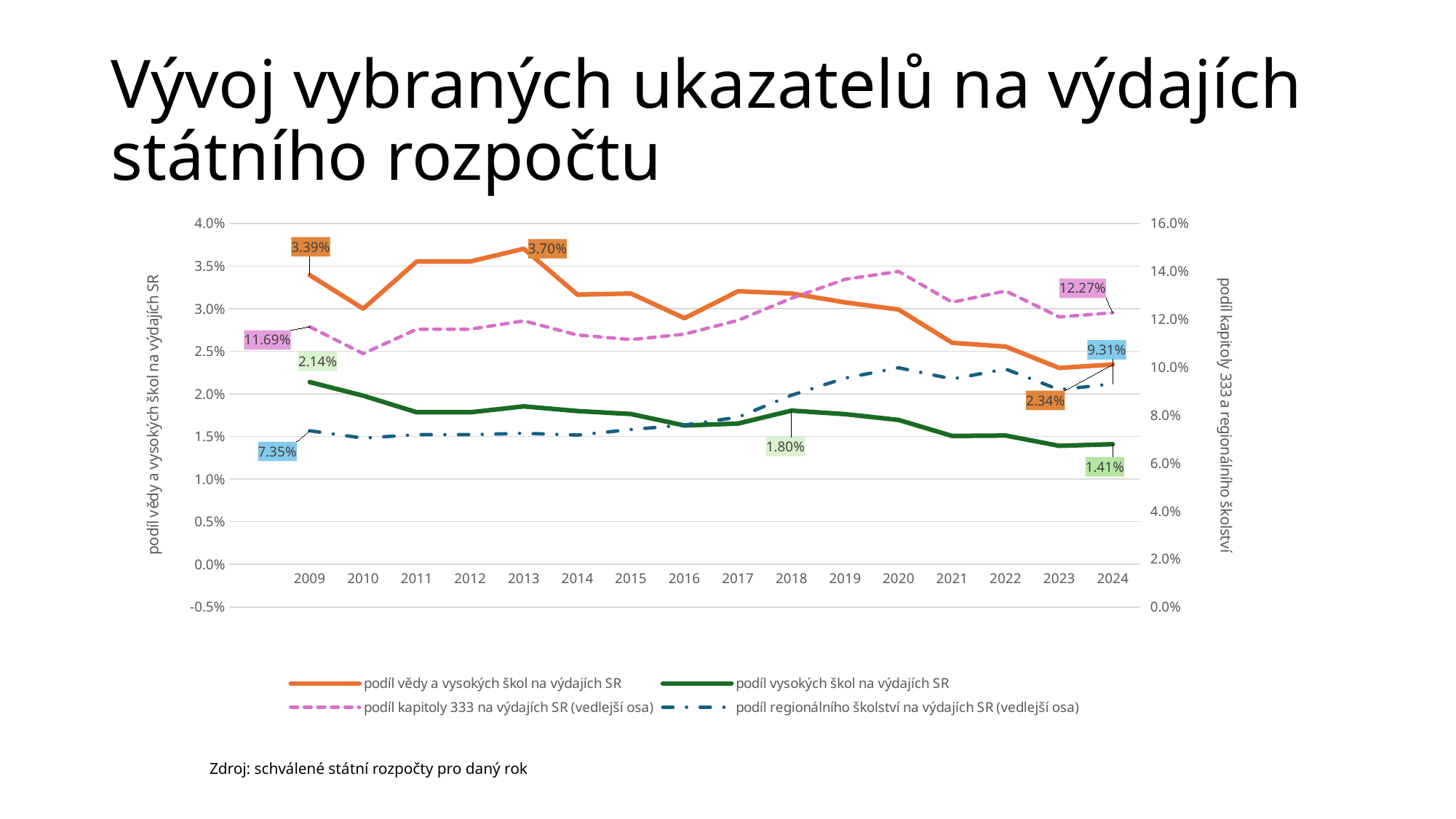
Is the value of 'podíl kapitoly 333 na výdajích SR (vedlejší osa)' in 2020 greater or less than 13.0%? greater How many series does the legend list? 4 What kind of chart is shown on the slide? line chart What is the value of 'podíl kapitoly 333 na výdajích SR (vedlejší osa)' in 2024? 12.27% What is the value of 'podíl vědy a vysokých škol na výdajích SR' in 2013? 3.70% By how many percentage points did 'podíl regionálního školství na výdajích SR' rise from 2009 (7.35%) to 2024 (9.31%)? 1.96 percentage points How many years are shown on the x axis? 16 What is the value of 'podíl regionálního školství na výdajích SR (vedlejší osa)' in 2009? 7.35% Does 'podíl vysokých škol na výdajích SR' rise or fall overall from 2009 to 2024? fall By how many percentage points did 'podíl vysokých škol na výdajích SR' fall from 2009 (2.14%) to 2024 (1.41%)? 0.73 percentage points What is the value of 'podíl vysokých škol na výdajích SR' in 2024? 1.41% What is the value of 'podíl vědy a vysokých škol na výdajích SR' in 2009? 3.39%